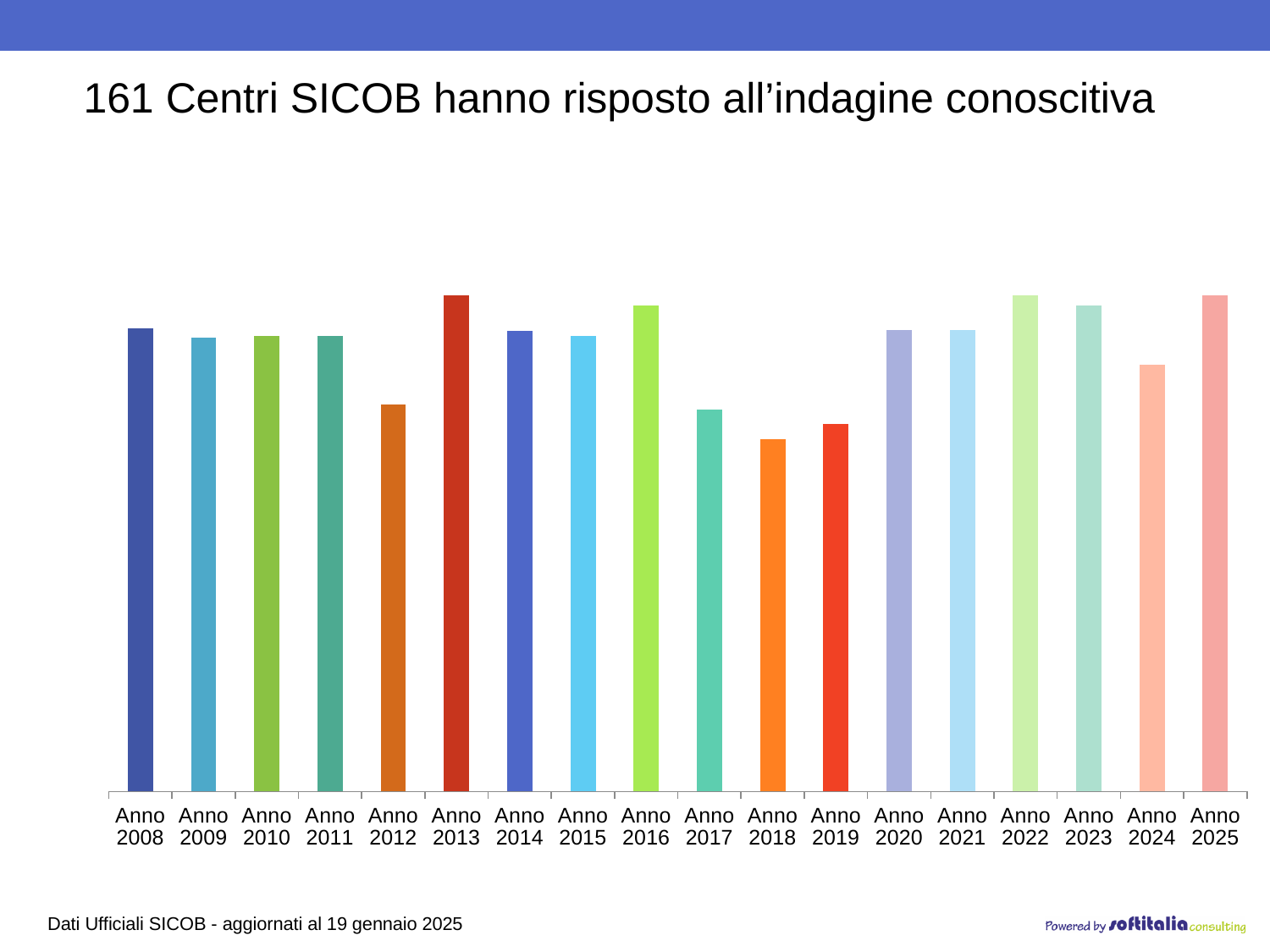
What kind of chart is shown on the slide? bar chart Which is larger, the value for Anno 2012 or the value for Anno 2013? Anno 2013 What is the label of the first category on the x axis? Anno 2008 Do the values rise or fall from Anno 2016 to Anno 2018? fall Which is larger, the value for Anno 2024 or the value for Anno 2025? Anno 2025 What is the title of the slide containing the chart? 161 Centri SICOB hanno risposto all'indagine conoscitiva Do the values rise or fall from Anno 2018 to Anno 2022? rise Which is larger, the value for Anno 2016 or the value for Anno 2017? Anno 2016 Which year has the lowest bar in the chart? Anno 2018 How many years (bars) are shown on the x axis of the chart? 18